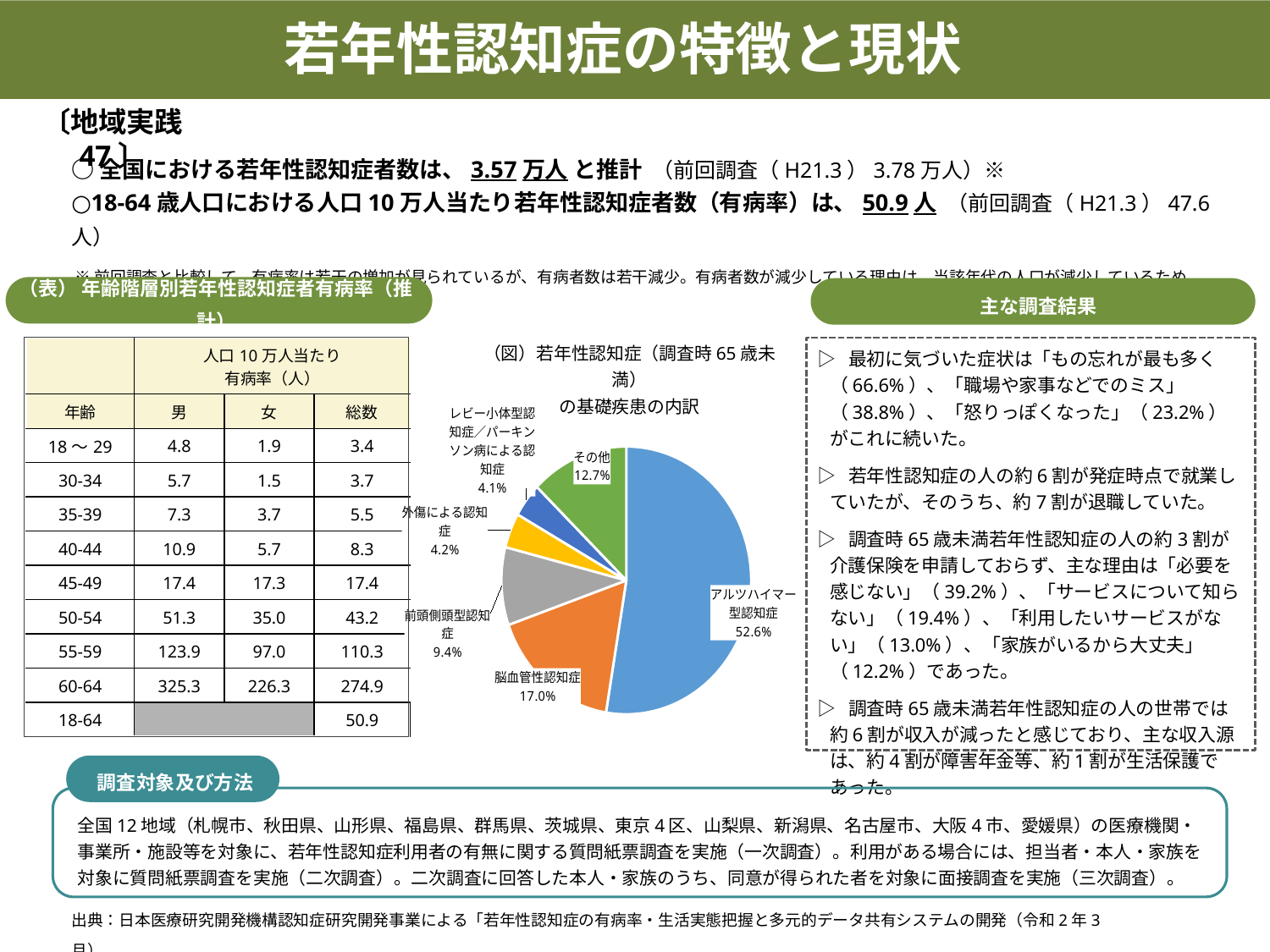
In the pie chart, what share is アルツハイマー型認知症? 52.6% What is the title of the pie chart? （図）若年性認知症（調査時65歳未満）の基礎疾患の内訳 What is the difference in percentage points between アルツハイマー型認知症 and 脳血管性認知症 in the pie chart? 35.6 How many slices does the pie chart have? 6 In the pie chart, what share is その他? 12.7% Which slice of the pie chart is the largest? アルツハイマー型認知症 What kind of chart is shown on the slide? pie chart Which slice of the pie chart is the smallest? レビー小体型認知症／パーキンソン病による認知症 Which is larger in the pie chart, その他 or 前頭側頭型認知症? その他 In the pie chart, what share is 前頭側頭型認知症? 9.4% In the pie chart, what share is 外傷による認知症? 4.2% In the pie chart, what share is 脳血管性認知症? 17.0%